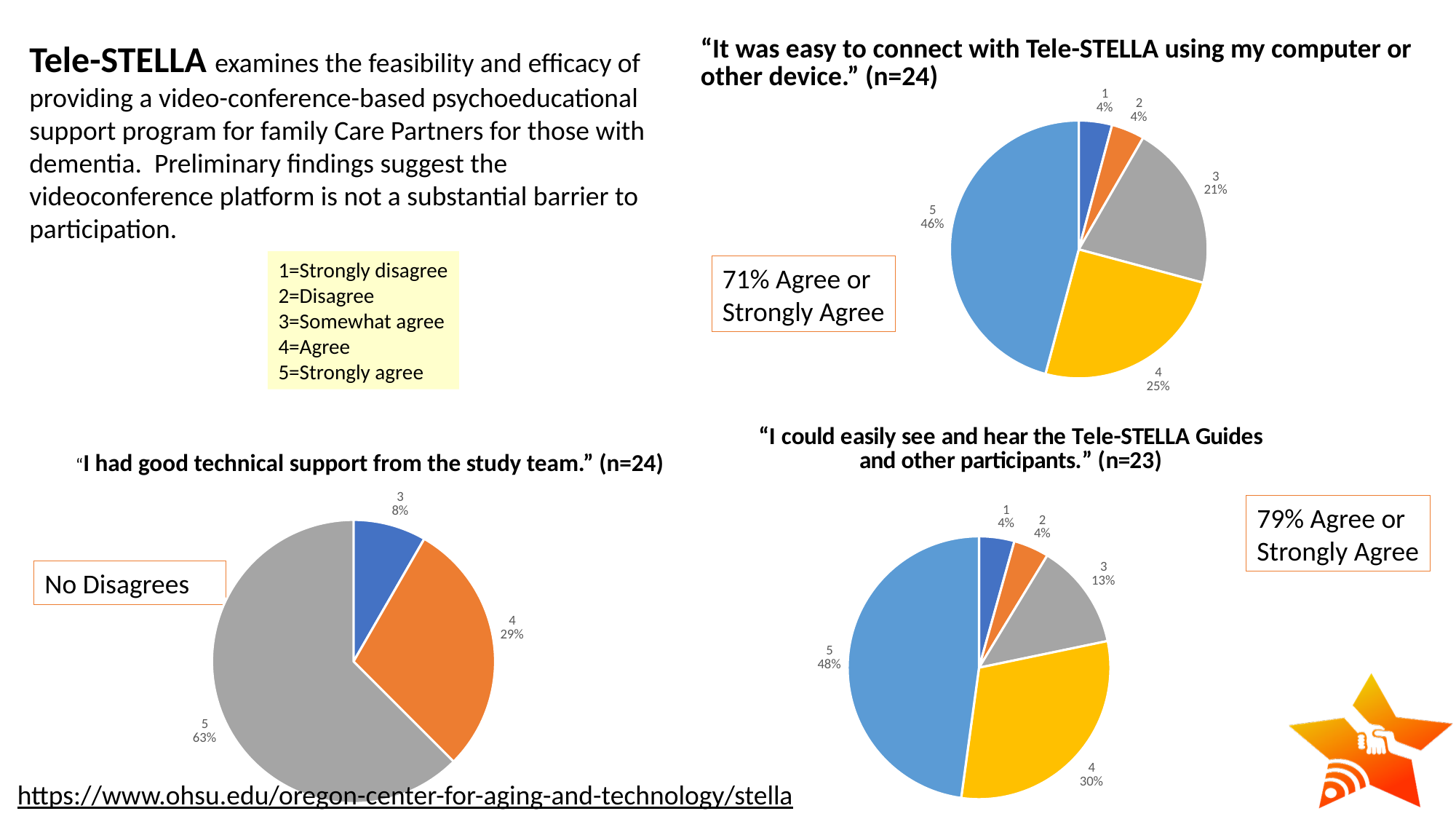
In the pie chart titled "I could easily see and hear the Tele-STELLA Guides and other participants," what share of responses is rating 3? 13% In the pie chart titled "I could easily see and hear the Tele-STELLA Guides and other participants," what share of responses is rating 4? 30% In the pie chart titled "It was easy to connect with Tele-STELLA using my computer or other device," which rating has the largest slice? 5 In the pie chart titled "I had good technical support from the study team," which rating has the smallest slice? 3 In the pie chart titled "I could easily see and hear the Tele-STELLA Guides and other participants," which is larger, the slice for rating 3 or the slice for rating 4? 4 In the pie chart titled "It was easy to connect with Tele-STELLA using my computer or other device," what share of responses is rating 3? 21% In the pie chart titled "I had good technical support from the study team," what is the difference in percentage points between rating 5 and rating 4? 34 In the pie chart titled "I had good technical support from the study team," how many slices does the pie have? 3 What kind of chart is used for the three charts on the slide? Pie chart In the pie chart titled "It was easy to connect with Tele-STELLA using my computer or other device," how many slices does the pie have? 5